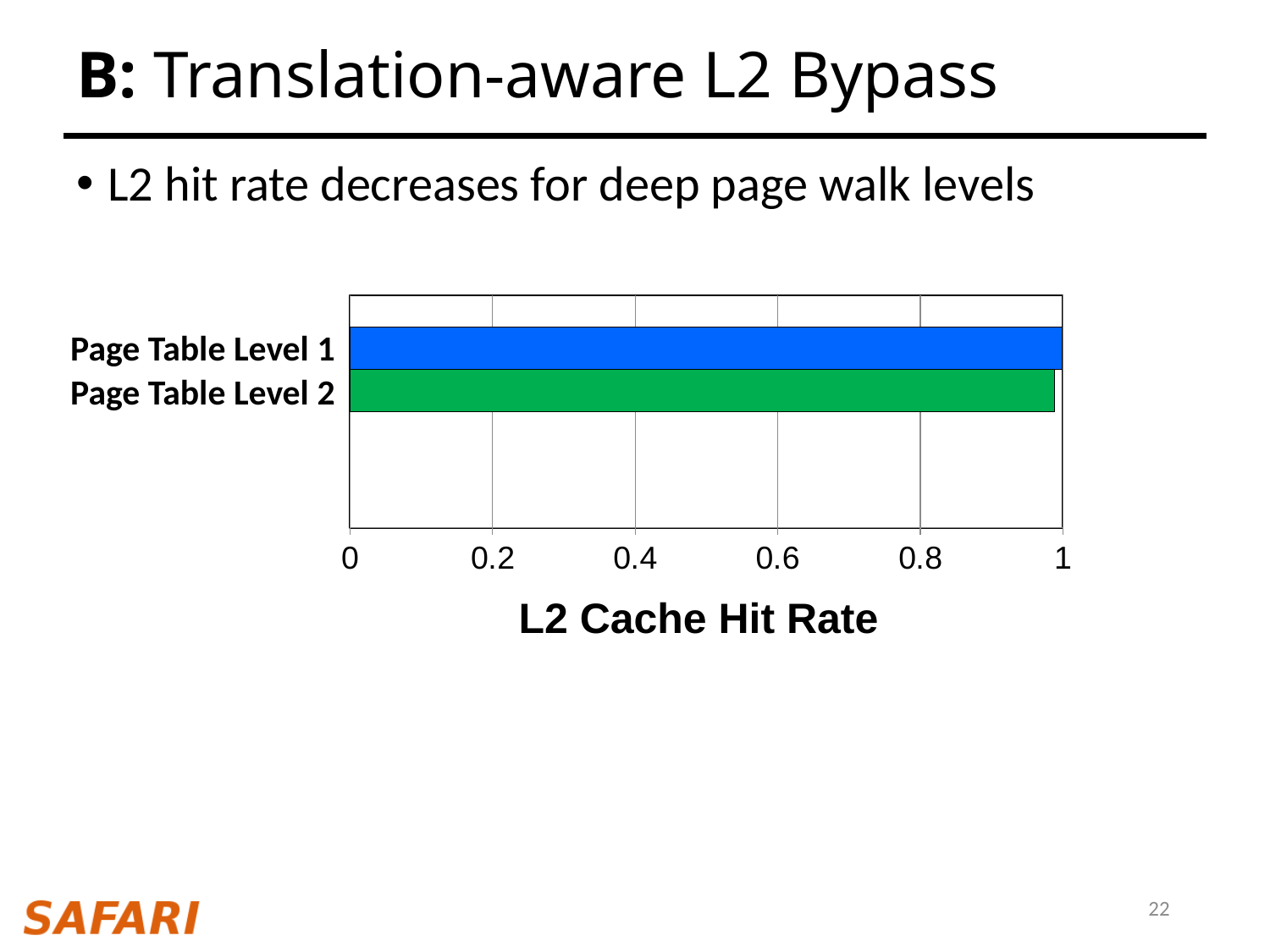
Is the value for Page Table Level 1 greater or less than 0.8? greater How many categories are plotted in the chart? 2 What is the title of the horizontal axis of the chart? L2 Cache Hit Rate Is the value for Page Table Level 2 greater or less than 0.6? greater Is the value for Page Table Level 1 greater or less than 0.4? greater What colour is the bar for Page Table Level 2? green What kind of chart is shown on the slide? bar chart